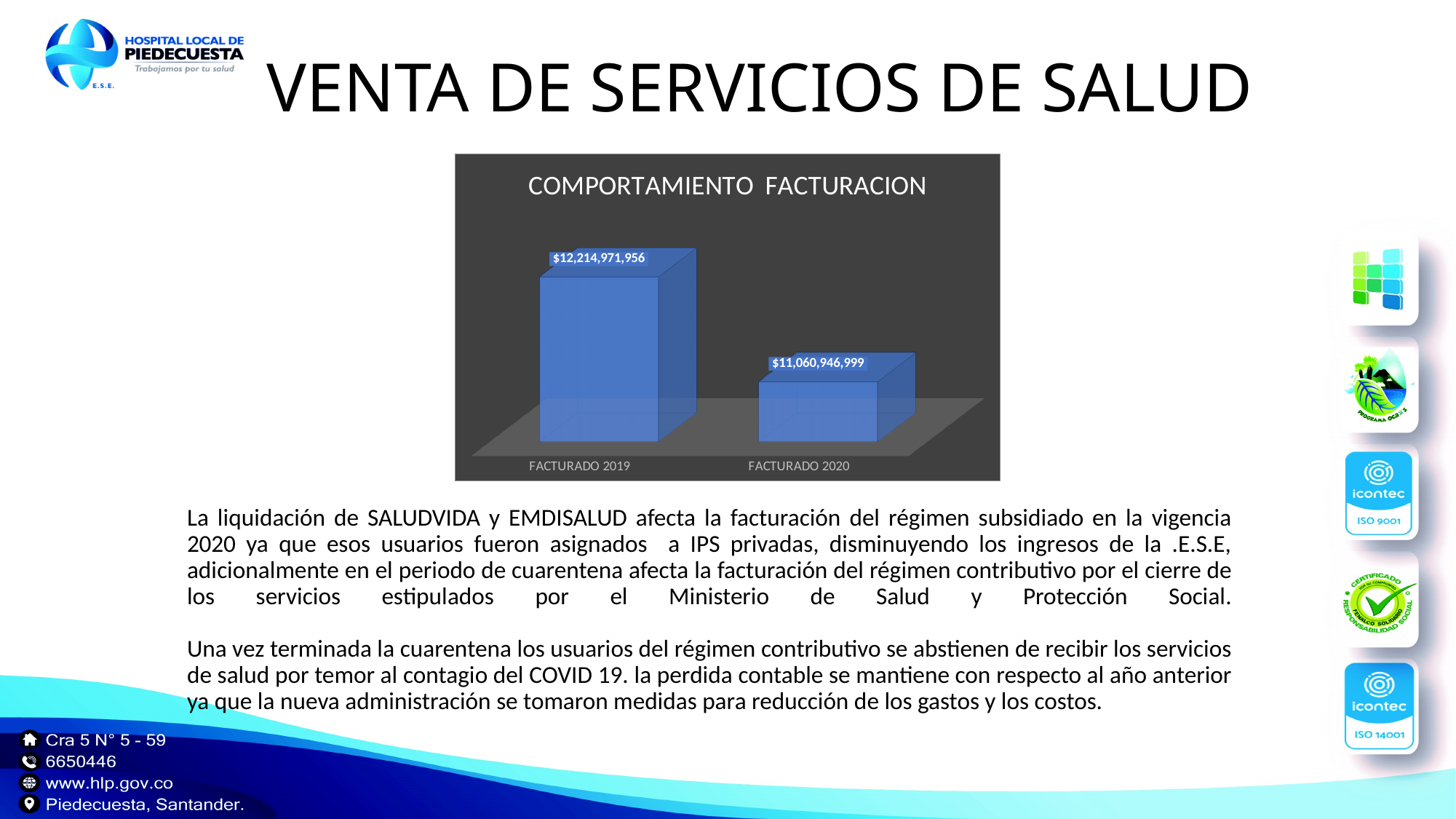
How many categories are shown in the chart? 2 Do the values rise or fall from FACTURADO 2019 to FACTURADO 2020? Fall What is the difference between the values for FACTURADO 2019 and FACTURADO 2020? $1,154,024,957 What colour are the bars in the chart? Blue Which category has the highest value? FACTURADO 2019 What kind of chart is shown on the slide? Bar chart What is the value for FACTURADO 2019? $12,214,971,956 Which is larger, the value for FACTURADO 2019 or FACTURADO 2020? FACTURADO 2019 What is the value for FACTURADO 2020? $11,060,946,999 Which category has the lowest value? FACTURADO 2020 What is the title of the chart? COMPORTAMIENTO FACTURACION